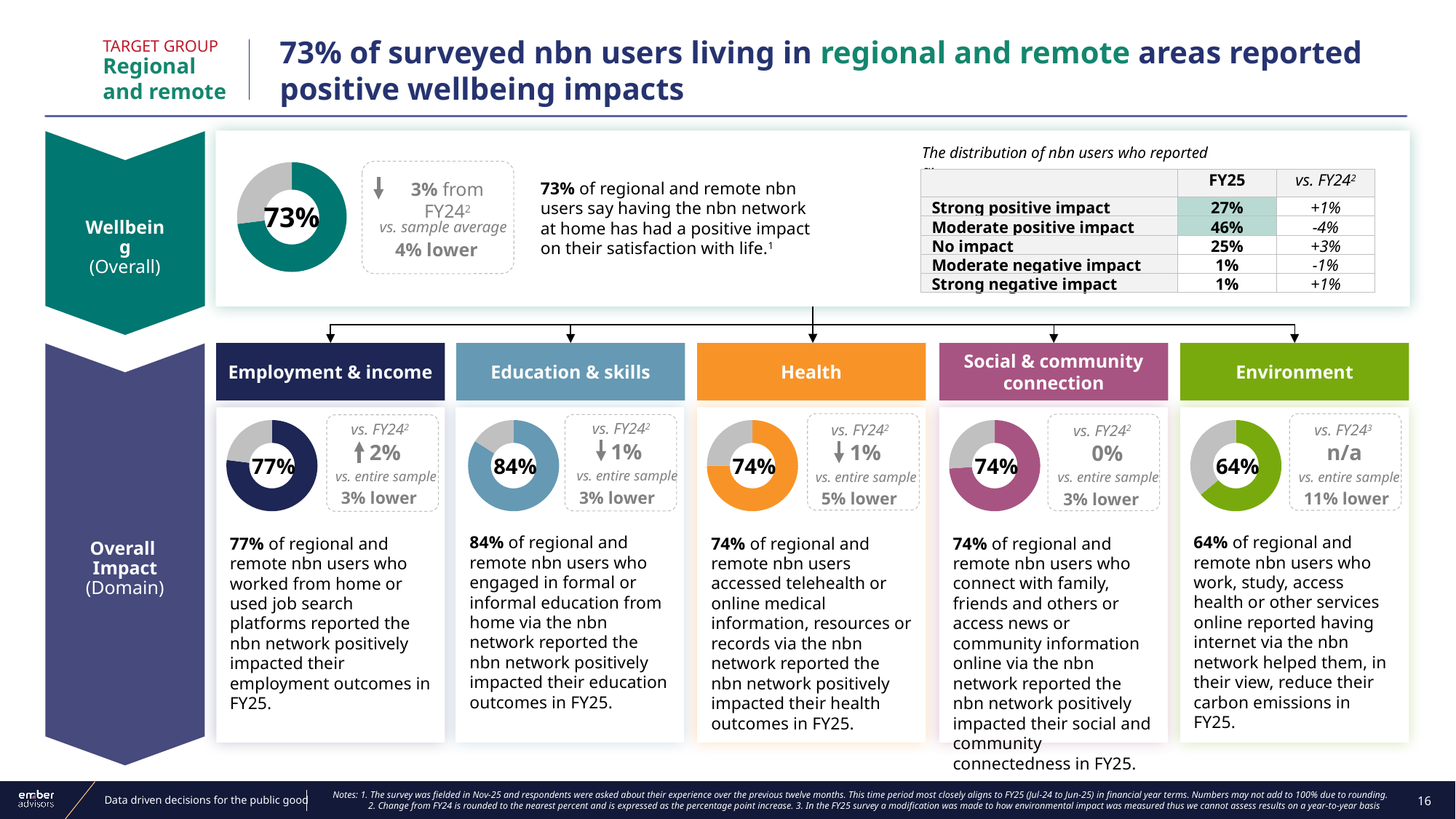
Do the Health and Social & community connection donut charts show the same percentage? Yes, both 74% What is the difference between the percentages shown in the Education & skills and Environment donut charts? 20% What value is shown in the Employment & income donut chart? 77% Which of the five domain donut charts (Employment & income, Education & skills, Health, Social & community connection, Environment) shows the highest percentage? Education & skills What value is shown in the Environment donut chart? 64% What percentage is shown in the centre of the Wellbeing (Overall) donut chart? 73% How many donut charts are shown on the slide? 6 What kind of chart is used to show the 73% wellbeing figure? Donut chart What colour is the filled portion of the Health donut chart? Orange What value is shown in the Education & skills donut chart? 84% Which shows a larger percentage, the Employment & income donut chart or the Health donut chart? Employment & income Which of the five domain donut charts shows the lowest percentage? Environment